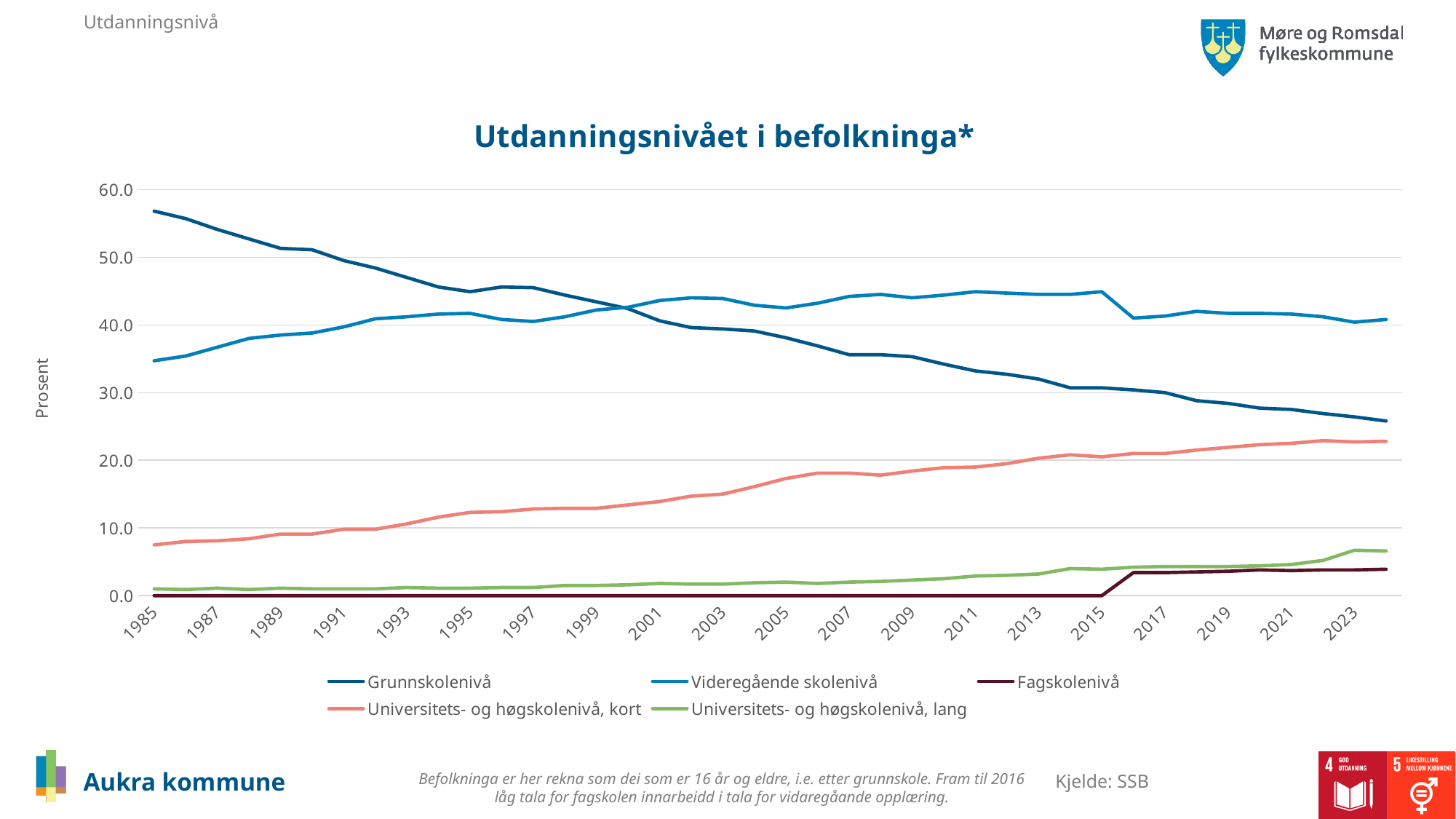
Does the Grunnskolenivå line rise or fall from 1985 to 2023? fall Which series has the highest value in 2023? Videregående skolenivå How many series does the legend list? 5 What is the label on the vertical axis? Prosent Is the value for Grunnskolenivå in 1985 greater or less than 50? greater Is the value for Videregående skolenivå in 1985 greater or less than 40? less Is the value for Grunnskolenivå in 2023 greater or less than 30? less In 1985, which is larger: Grunnskolenivå or Videregående skolenivå? Grunnskolenivå What kind of chart is shown on the slide? line chart Does the Universitets- og høgskolenivå, kort line rise or fall from 1985 to 2023? rise What is the title of the chart? Utdanningsnivået i befolkninga*